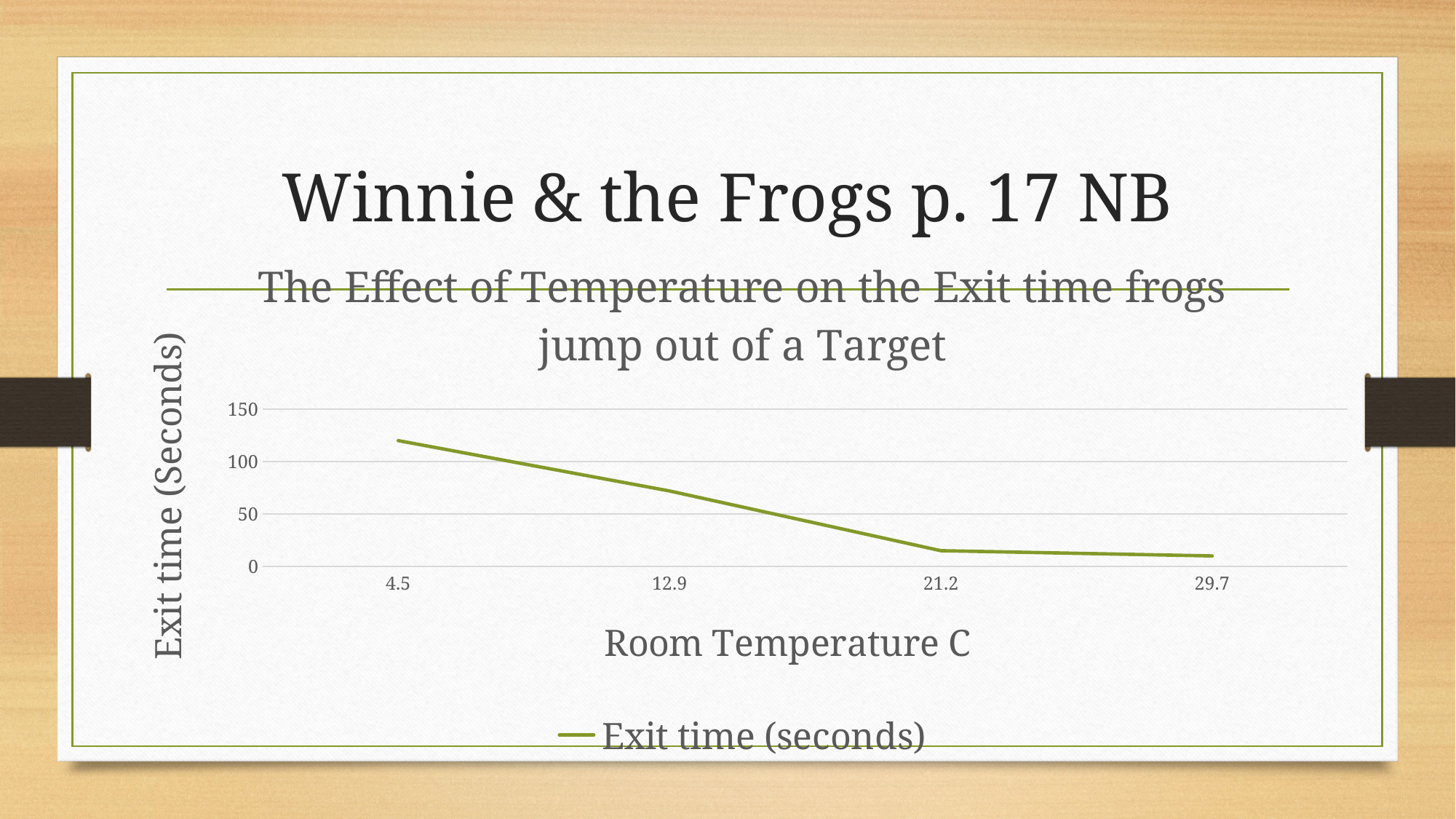
Is the exit time at 12.9 C greater or less than 100 seconds? less Which has a larger exit time, 4.5 C or 12.9 C? 4.5 How many series does the legend list? 1 Is the exit time at 12.9 C greater or less than 50 seconds? greater What kind of chart is shown on the slide? Line chart Is the exit time at 29.7 C greater or less than 50 seconds? less How many data points are plotted on the chart? 4 At which room temperature is the exit time highest? 4.5 Does the exit time rise or fall as room temperature increases along the x axis? Fall What is the label of the x axis? Room Temperature C